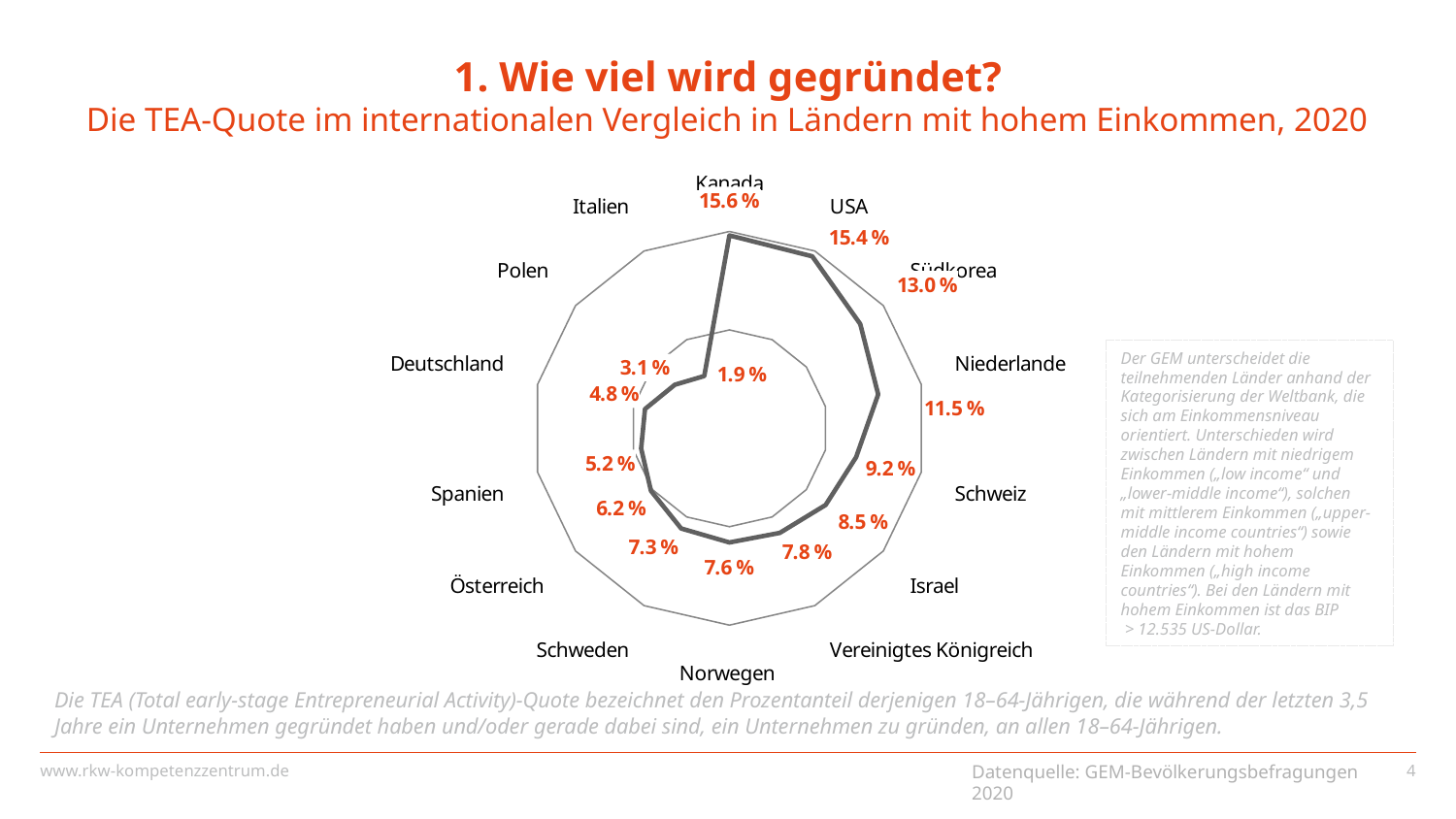
What is the TEA-Quote for Kanada? 15.6 % Which country has the lowest TEA-Quote? Italien What kind of chart is shown on the slide? Radar chart What is the TEA-Quote for Niederlande? 11.5 % Which country has the highest TEA-Quote? Kanada What is the subtitle of the chart? Die TEA-Quote im internationalen Vergleich in Ländern mit hohem Einkommen, 2020 What is the TEA-Quote for Deutschland? 4.8 % What is the TEA-Quote for Vereinigtes Königreich? 7.8 % What is the difference between the TEA-Quote of Kanada and USA? 0.2 percentage points What is the difference between the TEA-Quote of Spanien and Deutschland? 0.4 percentage points Which has a higher TEA-Quote, Schweiz or Israel? Schweiz How many countries are plotted in the chart? 14